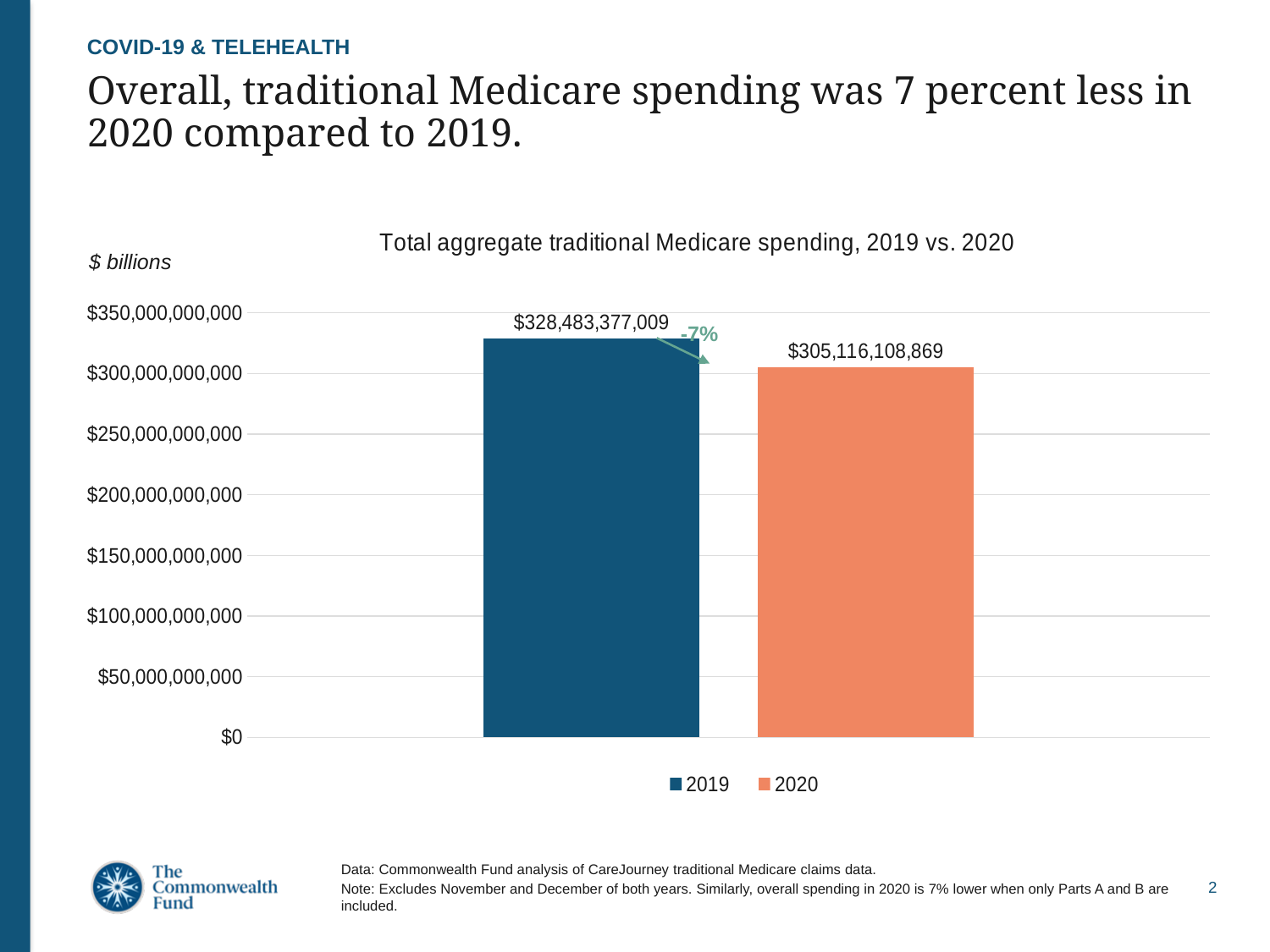
Is the value for 2019 greater or less than $350,000,000,000? less How many bars are plotted in the chart? 2 Which year has the lower spending value? 2020 How many series does the legend list? 2 What is the value of the 2020 bar? $305,116,108,869 Which year has the higher spending value? 2019 Is the 2020 value larger or smaller than the 2019 value? smaller What is the value of the 2019 bar? $328,483,377,009 Is the value for 2020 greater or less than $300,000,000,000? greater What is the difference between the 2019 and 2020 values? $23,367,268,140 What kind of chart is shown on the slide? bar chart What percentage change is annotated between the 2019 and 2020 bars? -7%